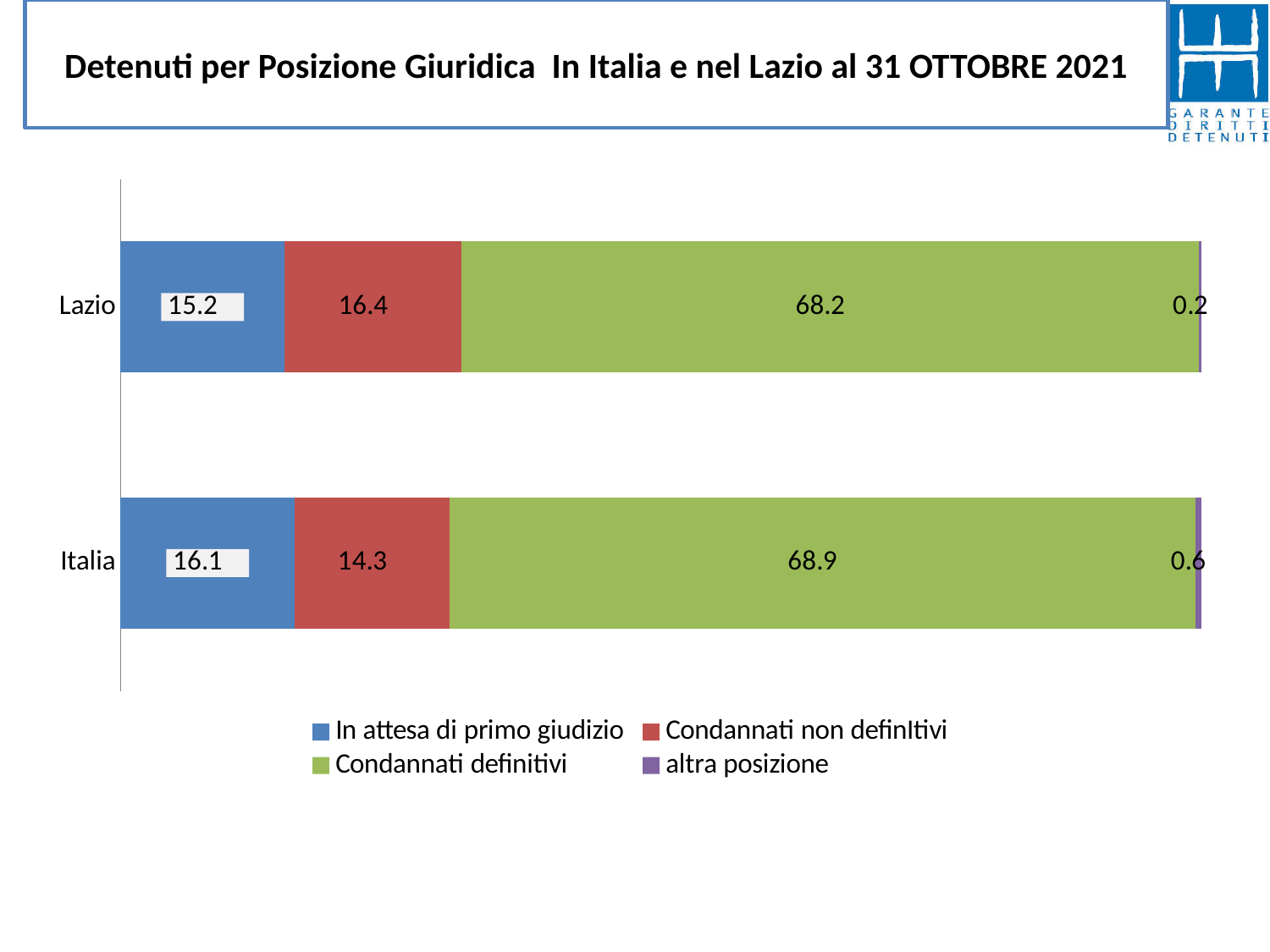
Which is larger: 'In attesa di primo giudizio' for Lazio or for Italia? Italia What is the difference between the 'Condannati non definitivi' values for Lazio and Italia? 2.1 How many series does the legend list? 4 What kind of chart is shown on the slide? Stacked bar chart Which series has the largest value for Italia? Condannati definitivi What is the value for 'Condannati non definitivi' for Italia? 14.3 What is the value for 'altra posizione' for Italia? 0.6 What is the value for 'Condannati definitivi' for Lazio? 68.2 Which series has the smallest value for Lazio? altra posizione What is the value for 'In attesa di primo giudizio' for Lazio? 15.2 What is the total of the stacked bar for Lazio? 100.0 How many categories are shown on the vertical axis? 2